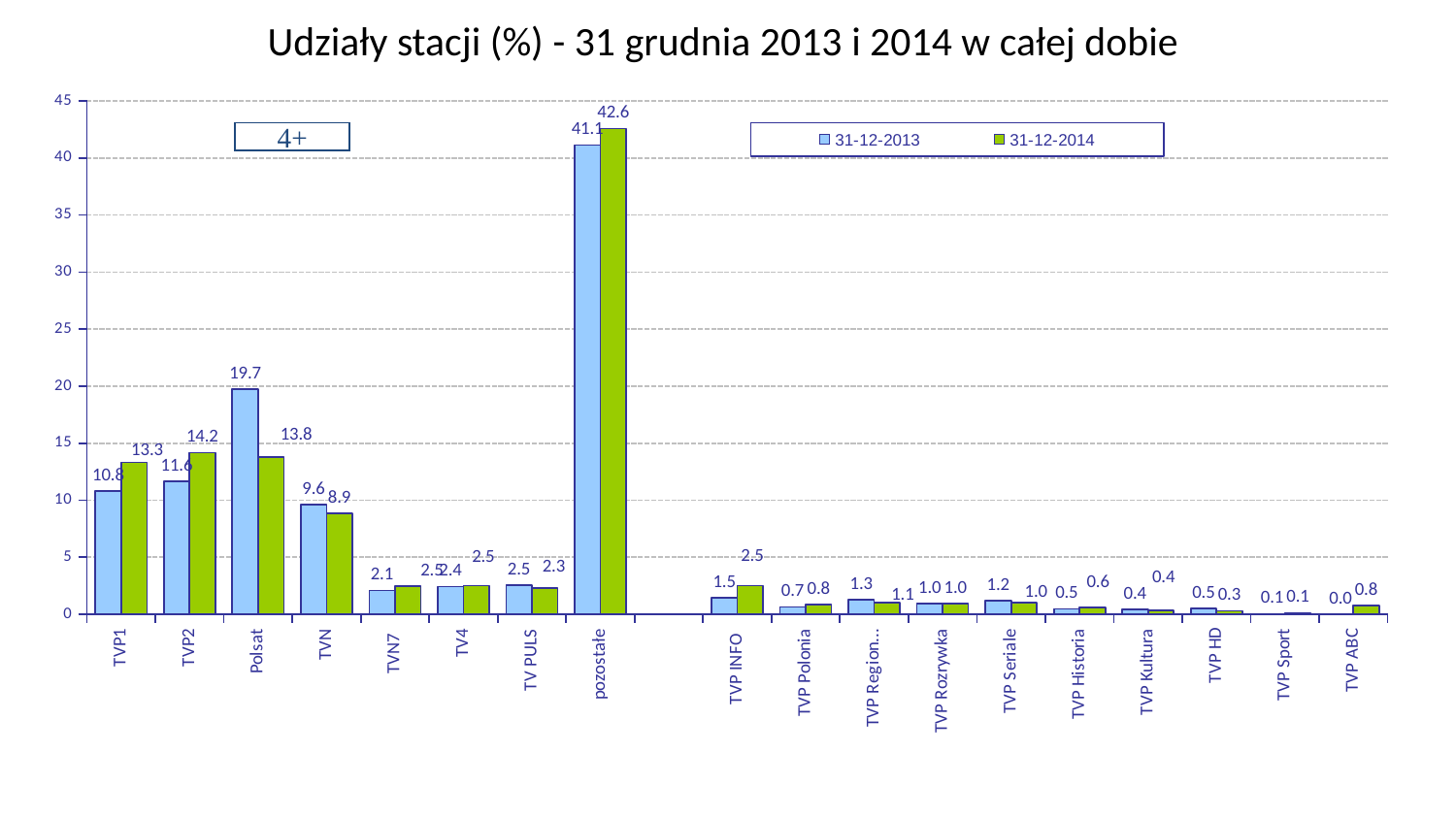
Is the 31-12-2014 value for pozostałe greater or less than 40? greater What is the difference between the 31-12-2013 and 31-12-2014 values for Polsat? 5.9 What is the difference between the 31-12-2014 and 31-12-2013 values for TVP INFO? 1.0 In the 31-12-2013 series, which is larger: TVP2 or TVN? TVP2 What is the title of the chart? Udziały stacji (%) - 31 grudnia 2013 i 2014 w całej dobie What is the value for TVP ABC in the 31-12-2013 series? 0.0 How many series does the legend list? 2 Which category has the highest value in the 31-12-2014 series? pozostałe What is the value for TVP1 in the 31-12-2014 series? 13.3 What kind of chart is shown on the slide? bar chart What is the value for Polsat in the 31-12-2013 series? 19.7 How many categories are shown on the x axis? 18